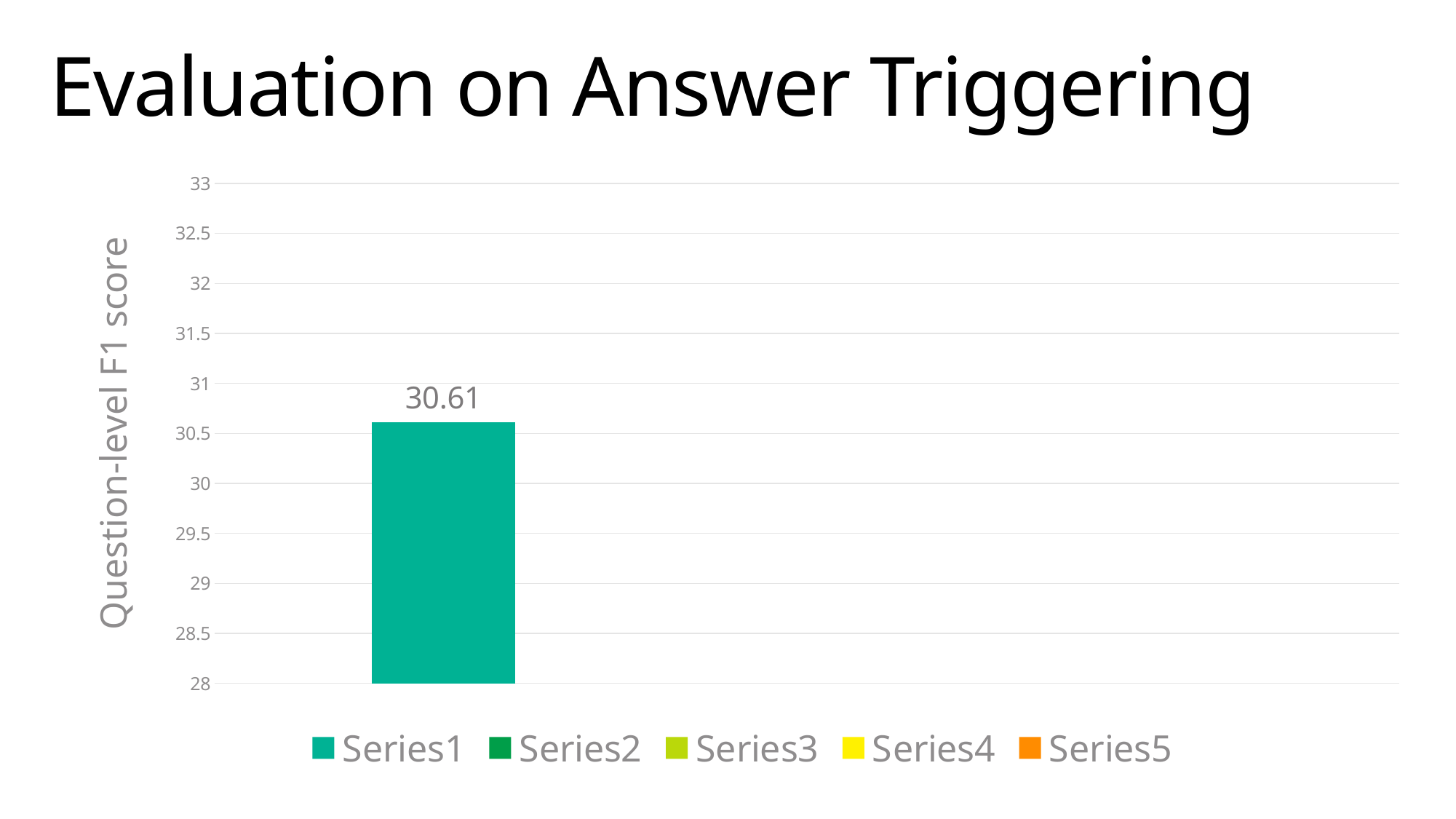
What is the highest value shown on the vertical axis? 33 How many series does the legend list? 5 What is the title of the slide containing the chart? Evaluation on Answer Triggering Is the value for Series1 greater or less than 30? greater What is the lowest value shown on the vertical axis? 28 Which series has a bar plotted in the chart? Series1 What is the value of the Series1 bar? 30.61 What is the label of the vertical axis? Question-level F1 score What kind of chart is shown on the slide? bar chart How many bars are plotted in the chart? 1 Is the value for Series1 greater or less than 31? less